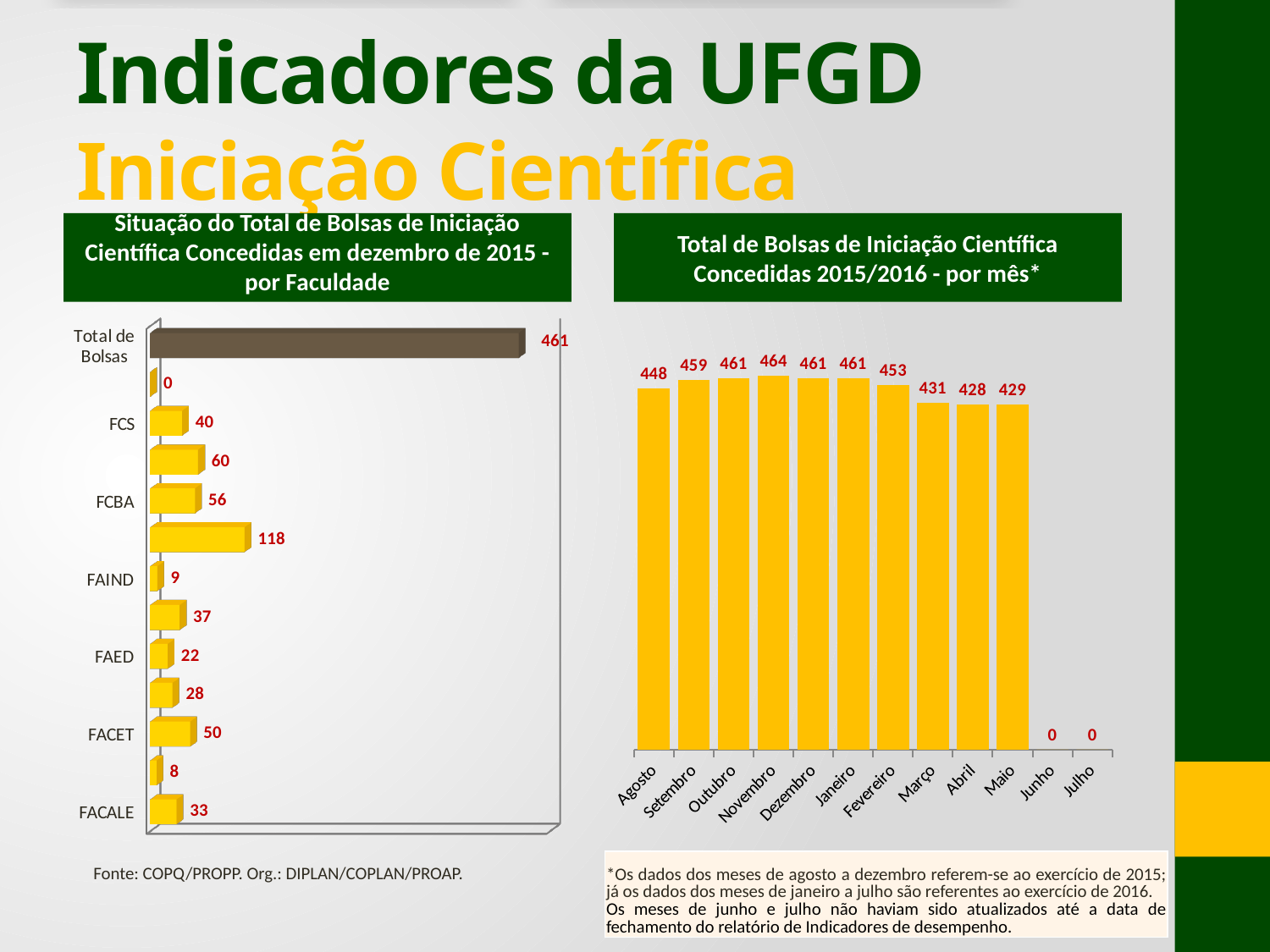
In the chart 'Total de Bolsas de Iniciação Científica Concedidas 2015/2016 - por mês', what is the value for Novembro? 464 In the chart 'Situação do Total de Bolsas de Iniciação Científica Concedidas em dezembro de 2015 - por Faculdade', what is the difference between the values for FACET and FAED? 28 In the chart 'Total de Bolsas de Iniciação Científica Concedidas 2015/2016 - por mês', do the values rise or fall from Novembro to Abril? fall In the chart 'Total de Bolsas de Iniciação Científica Concedidas 2015/2016 - por mês', which is larger, the value for Agosto or for Setembro? Setembro In the chart 'Total de Bolsas de Iniciação Científica Concedidas 2015/2016 - por mês', what is the value for Março? 431 In the chart 'Situação do Total de Bolsas de Iniciação Científica Concedidas em dezembro de 2015 - por Faculdade', what is the value for FACET? 50 In the chart 'Total de Bolsas de Iniciação Científica Concedidas 2015/2016 - por mês', which month has the highest value? Novembro In the chart 'Situação do Total de Bolsas de Iniciação Científica Concedidas em dezembro de 2015 - por Faculdade', what is the value for Total de Bolsas? 461 How many months are shown in the chart 'Total de Bolsas de Iniciação Científica Concedidas 2015/2016 - por mês'? 12 What kind of chart is 'Situação do Total de Bolsas de Iniciação Científica Concedidas em dezembro de 2015 - por Faculdade'? bar chart In the chart 'Total de Bolsas de Iniciação Científica Concedidas 2015/2016 - por mês', which month from Agosto to Maio has the lowest value? Abril In the chart 'Total de Bolsas de Iniciação Científica Concedidas 2015/2016 - por mês', what is the difference between the values for Novembro and Abril? 36